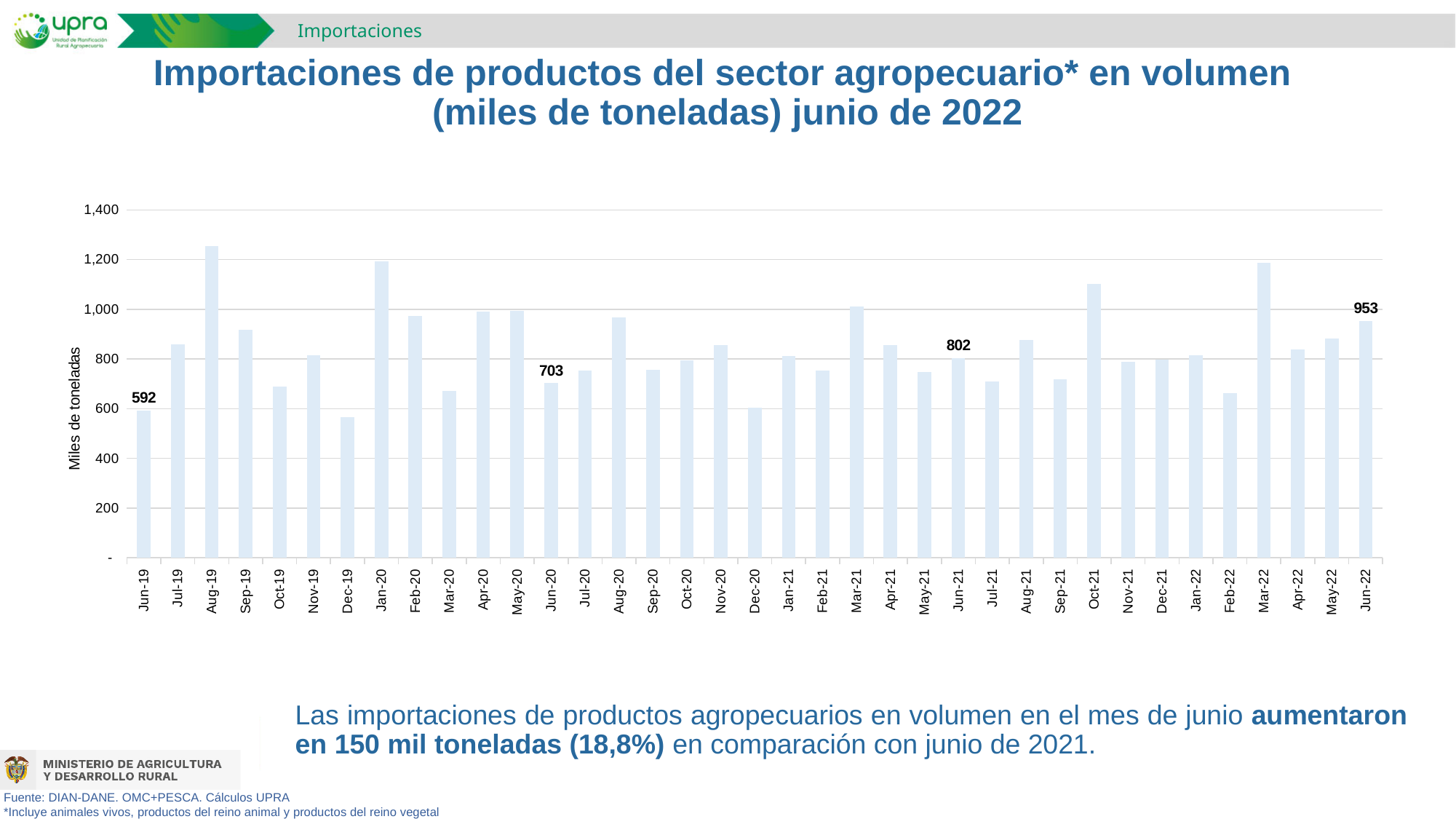
What is the difference between the values for Jun-22 and Jun-19? 361 How many months are plotted on the chart? 37 What is the value for Jun-21? 802 What kind of chart is shown? Bar chart Which is larger, the value for Jun-20 or the value for Jun-21? Jun-21 What is the value for Jun-19? 592 What is the difference between the values for Jun-22 and Jun-21? 150 What is the value for Jun-22? 953 What is the value for Jun-20? 703 Which month has the highest bar? Aug-19 Is the value for Dec-20 greater or less than 800? less Is the value for Oct-21 greater or less than 1,000? greater